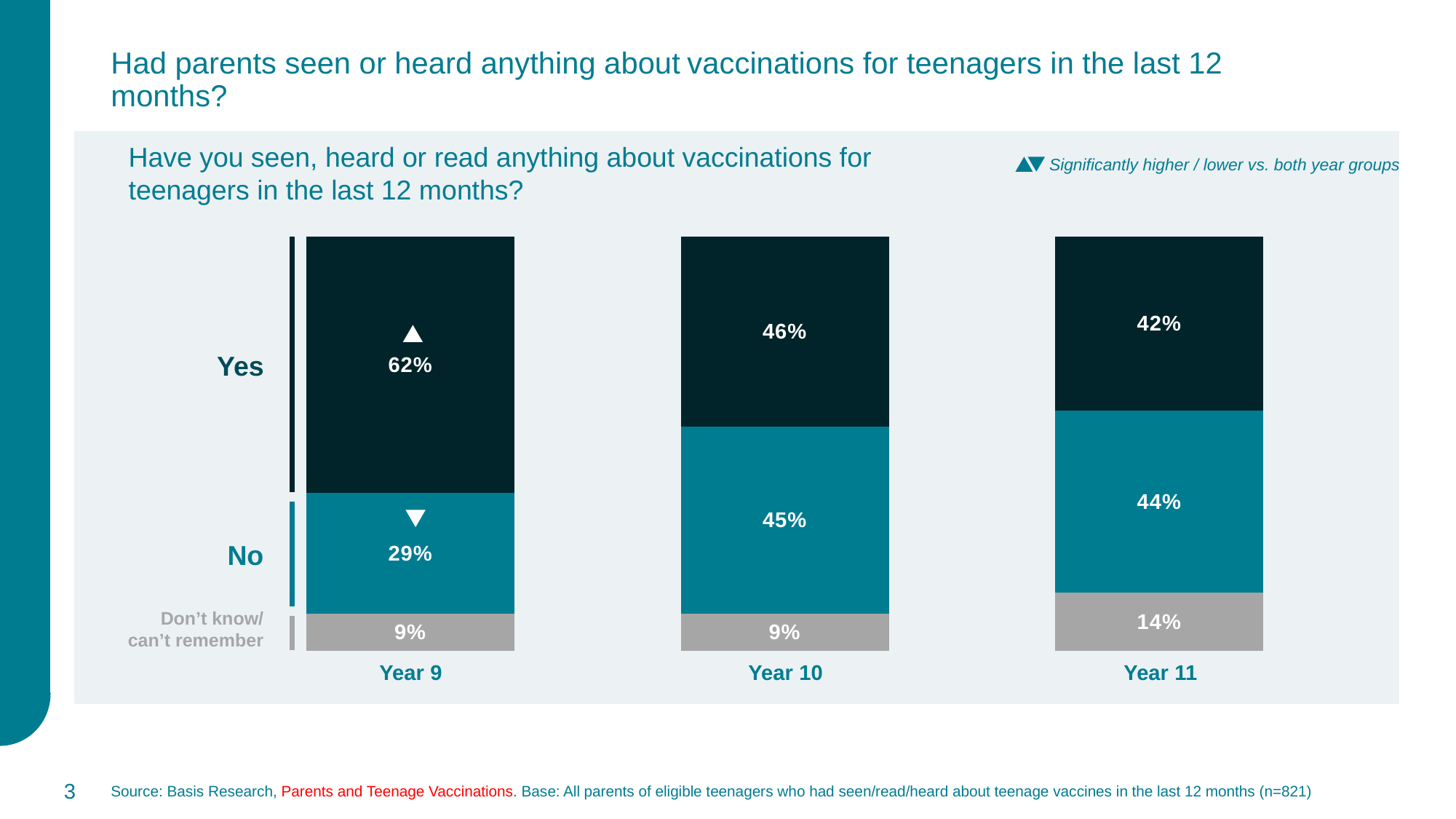
How many response categories are shown in each stacked bar? 3 How many year groups are shown on the chart? 3 Which is larger: the No percentage for Year 10 or for Year 11? Year 10 What percentage of Year 9 parents answered Yes? 62% Does the Yes percentage rise or fall from Year 9 to Year 11? Fall What percentage of Year 10 parents answered Don't know/can't remember? 9% Which year group has the lowest No percentage? Year 9 What is the difference between the Yes percentages for Year 9 and Year 11? 20% What do the triangle symbols next to the Year 9 values indicate? Significantly higher / lower vs. both year groups What percentage of Year 11 parents answered No? 44% What kind of chart is shown on the slide? Stacked bar chart Which year group has the highest Yes percentage? Year 9